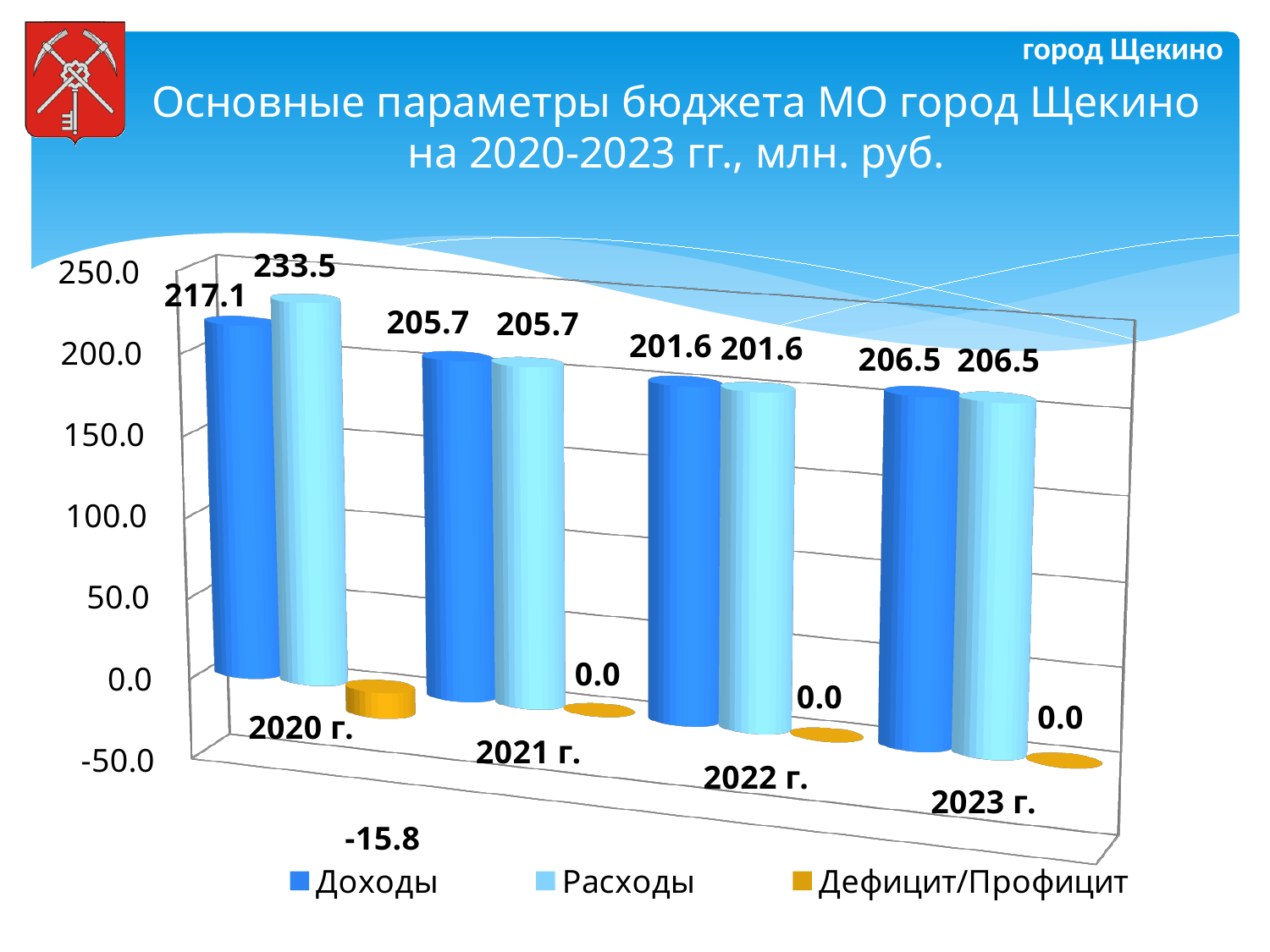
What is the difference between Расходы and Доходы in 2020 г.? 16.4 What is the value of Расходы for 2023 г.? 206.5 Which year has the highest Расходы value? 2020 г. What is the value of Доходы for 2020 г.? 217.1 What kind of chart is shown on the slide? Bar chart Which is larger in 2020 г., Доходы or Расходы? Расходы Which year has the lowest Доходы value? 2022 г. What is the value of Дефицит/Профицит for 2020 г.? -15.8 What is the value of Расходы for 2020 г.? 233.5 How many series does the legend list? 3 How many years are shown on the x axis? 4 What is the value of Доходы for 2022 г.? 201.6